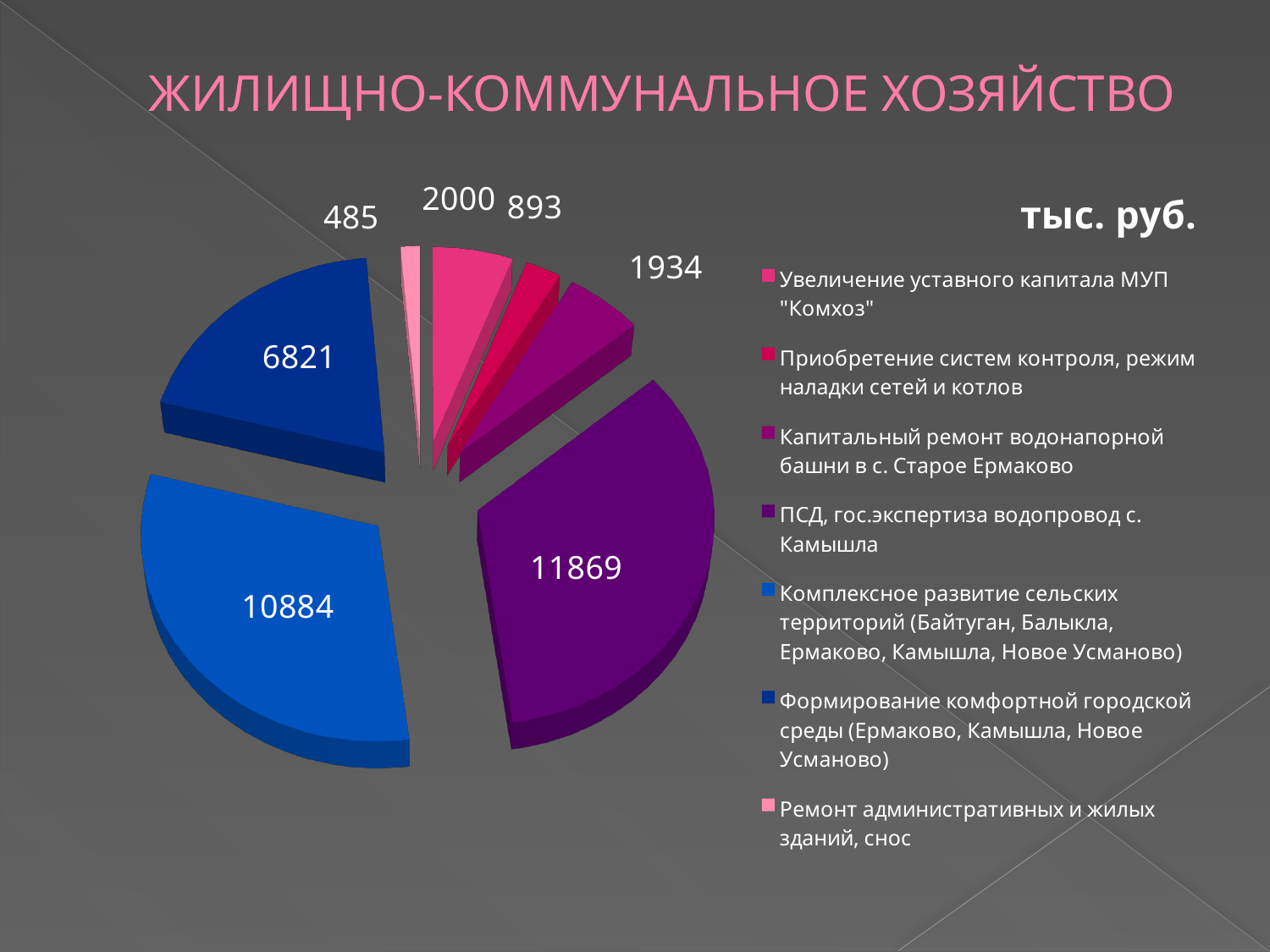
How many slices does the pie chart have? 7 What is the difference between the two largest slices, 11869 and 10884? 985 Which is larger: the slice labelled 1934 or the slice labelled 893? 1934 What kind of chart is shown on the slide? pie chart What unit is indicated for the values in the chart? тыс. руб. What is the value for "Формирование комфортной городской среды (Ермаково, Камышла, Новое Усманово)"? 6821 What is the title of the slide? ЖИЛИЩНО-КОММУНАЛЬНОЕ ХОЗЯЙСТВО How many entries does the legend list? 7 What is the value of the smallest slice of the pie chart? 485 What is the value of the largest slice of the pie chart? 11869 What is the value for "ПСД, гос.экспертиза водопровод с. Камышла"? 11869 What is the value for "Комплексное развитие сельских территорий (Байтуган, Балыкла, Ермаково, Камышла, Новое Усманово)"? 10884